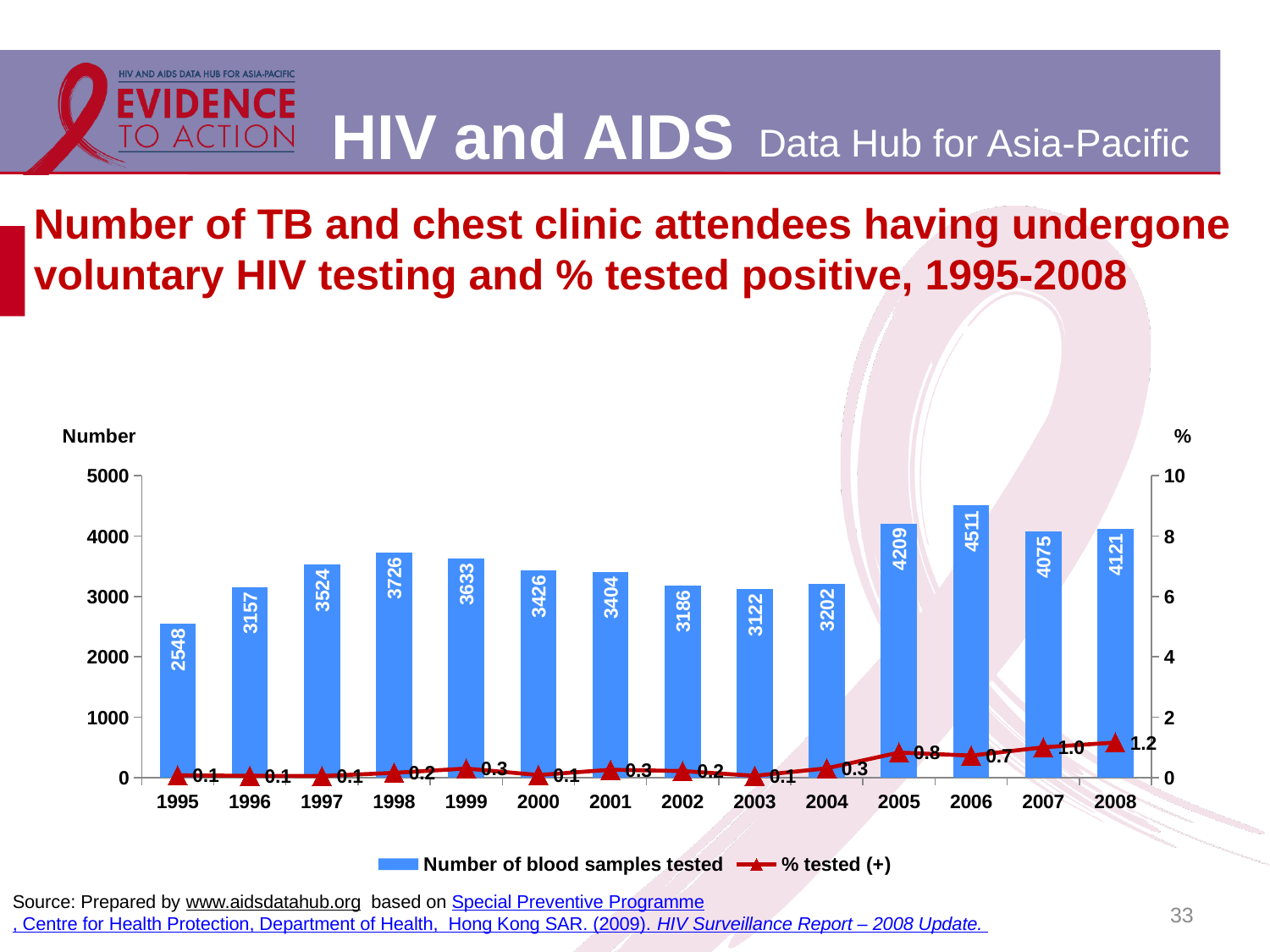
What was the % tested positive in 2008? 1.2 How many series does the legend list? 2 What kind of chart is used to show the number of blood samples tested? bar chart How many blood samples were tested in 2006? 4511 Which year had more blood samples tested, 2005 or 2007? 2005 Which year had the lowest number of blood samples tested? 1995 What is the label of the right-hand vertical axis? % How many years are shown on the x axis? 14 Does the % tested positive rise or fall from 2004 to 2008? rise Is the number of blood samples tested in 2003 greater or less than 4000? less What is the difference in the number of blood samples tested between 2006 and 1995? 1963 Which year had the highest number of blood samples tested? 2006